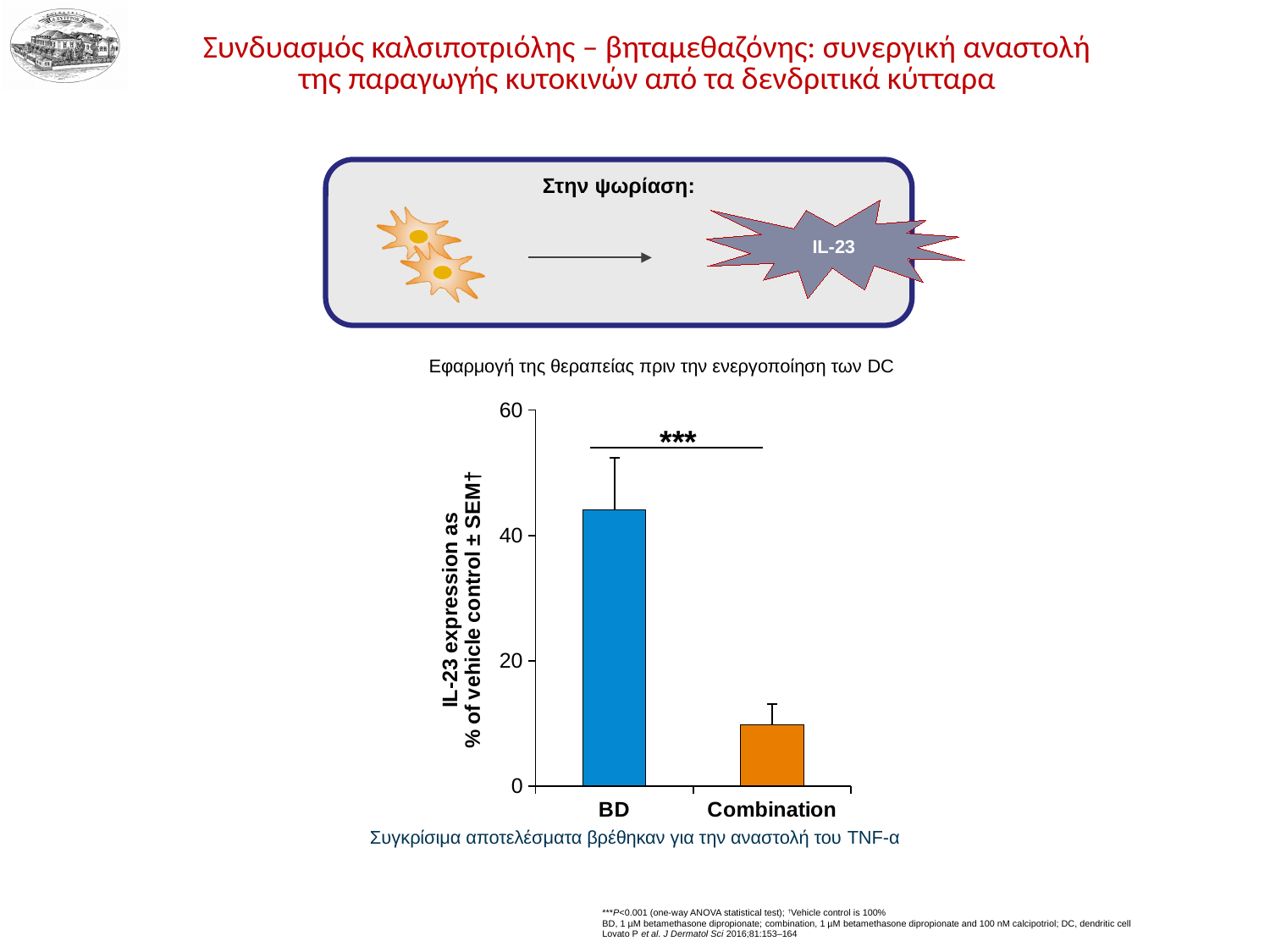
Is the value for BD greater or less than 60? less Is the value for Combination greater or less than 20? less How many bars (categories) are plotted in the chart? 2 What is the highest tick value shown on the y axis of the chart? 60 What kind of chart is shown on the slide? bar chart Which category has the lowest IL-23 expression in the chart? Combination What is the label of the y axis of the chart? IL-23 expression as % of vehicle control ± SEM† Is the value for BD greater or less than 40? greater Which category has the highest IL-23 expression in the chart? BD Which bar is taller, BD or Combination? BD